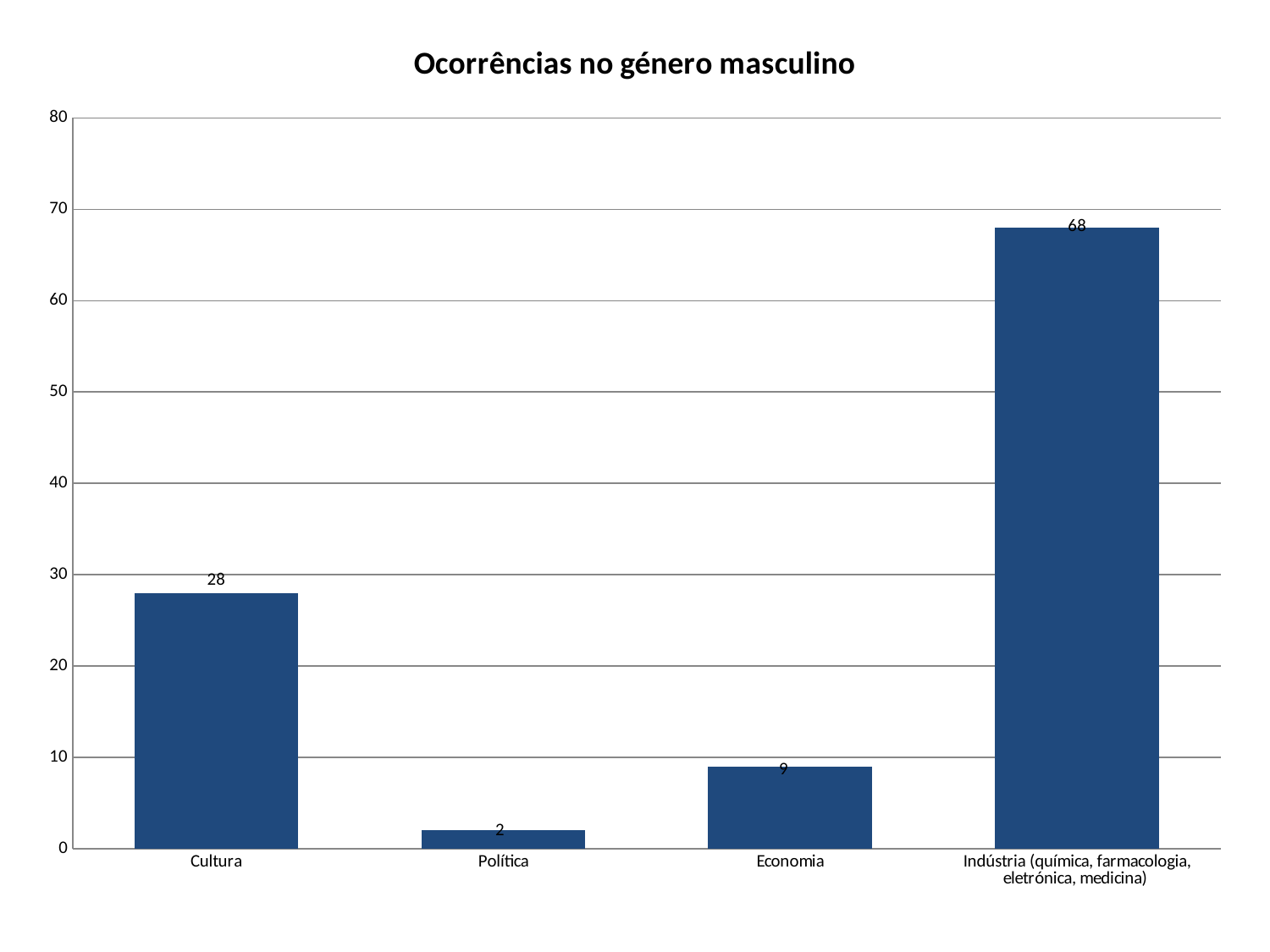
What is the value for Indústria (química, farmacologia, eletrónica, medicina)? 68 Which category has the highest value? Indústria (química, farmacologia, eletrónica, medicina) What is the value for Economia? 9 What is the value for Política? 2 Is the value for Indústria greater or less than 60? greater Which is larger, the value for Cultura or the value for Economia? Cultura What is the difference between the values for Indústria and Cultura? 40 What is the value for Cultura? 28 How many categories are shown on the x axis? 4 What is the difference between the values for Economia and Política? 7 Which category has the lowest value? Política What kind of chart is shown on the slide? Bar chart